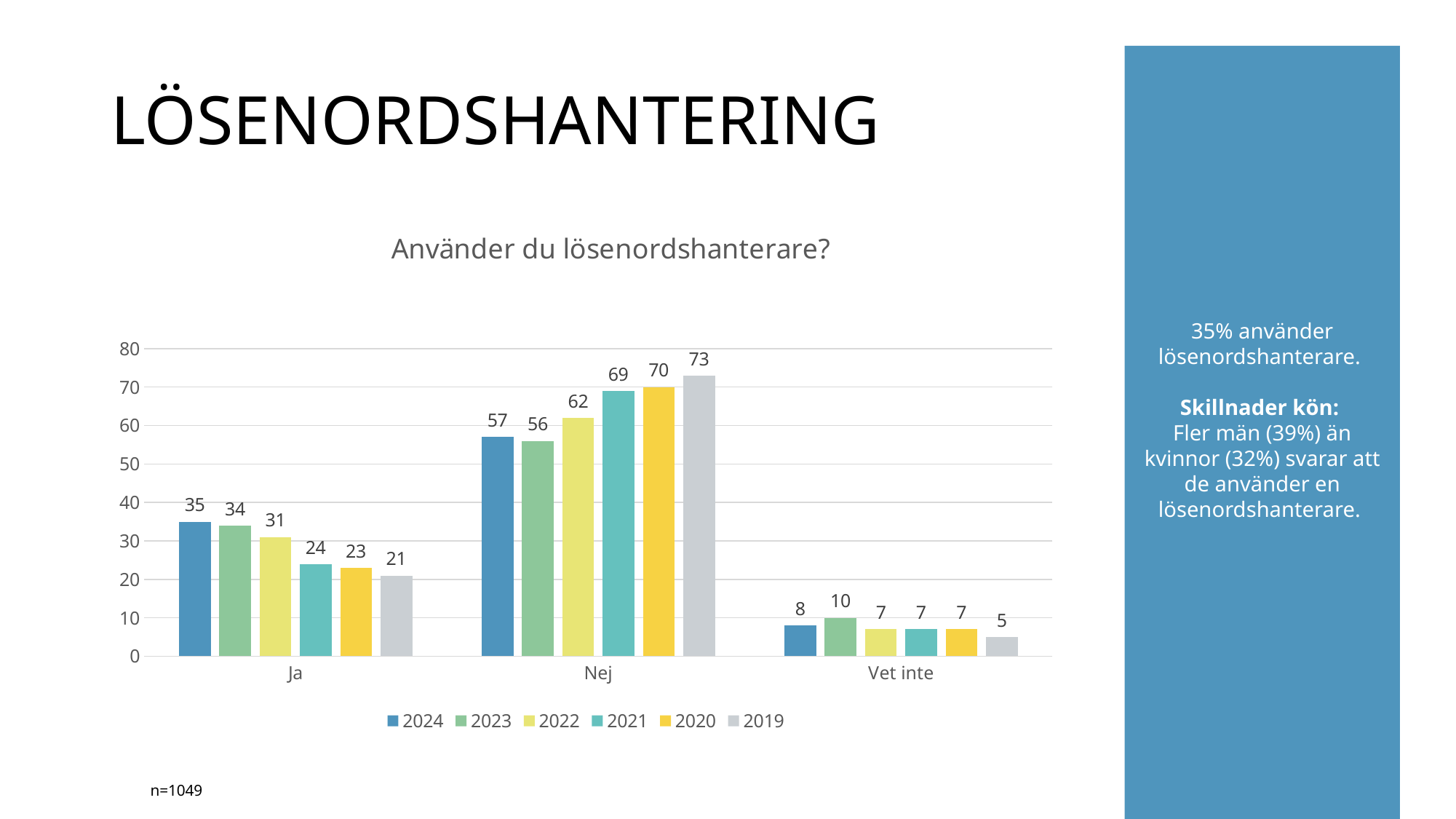
What is the value for 2024 in the "Ja" category? 35 How many categories are shown on the x axis? 3 What kind of chart is shown on the slide? Bar chart Which year has the highest value in the "Nej" category? 2019 How many series does the legend list? 6 Which year has the lowest value in the "Ja" category? 2019 What is the title of the chart? Använder du lösenordshanterare? What is the difference between the 2024 and 2019 values in the "Ja" category? 14 What is the value for 2019 in the "Nej" category? 73 Which is larger: the 2022 value for "Nej" or the 2021 value for "Nej"? 2021 What is the difference between the 2020 and 2024 values in the "Nej" category? 13 What is the value for 2023 in the "Vet inte" category? 10